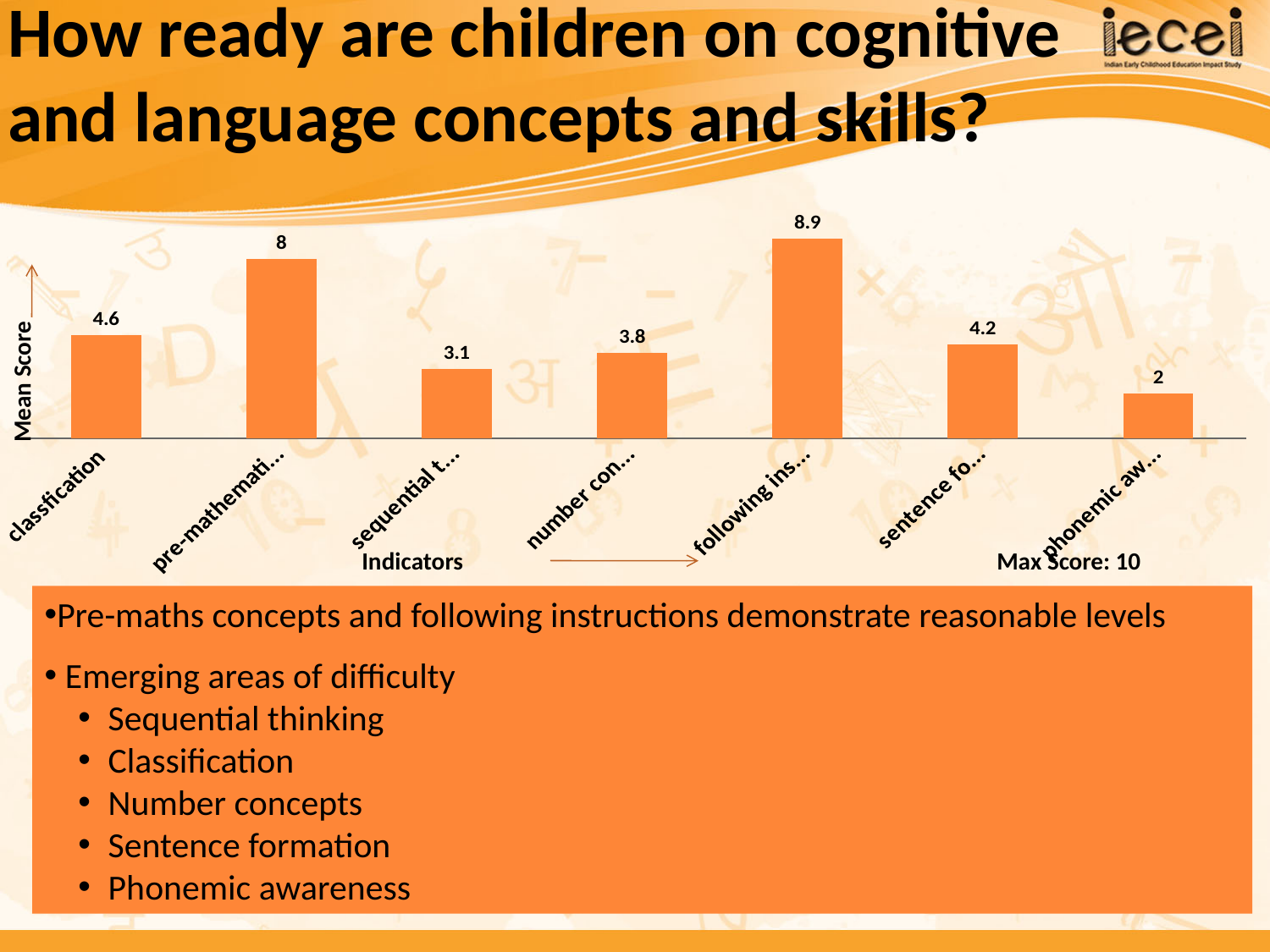
What is the mean score for classification? 4.6 What is the difference between the mean score for 'following ins...' and the mean score for 'pre-mathemati...'? 0.9 What is the mean score shown for the bar labelled 'phonemic aw...' (phonemic awareness)? 2 What type of chart is shown on the slide? bar chart What is the difference between the mean score for classification and the mean score for 'phonemic aw...'? 2.6 What is the mean score shown for the bar labelled 'sequential t...' (sequential thinking)? 3.1 Which indicator has the lowest mean score? phonemic aw... (phonemic awareness) What is the mean score shown for the bar labelled 'following ins...' (following instructions)? 8.9 Which indicator has the highest mean score? following ins... (following instructions) How many indicators (bars) are shown in the chart? 7 What is the maximum possible score noted on the chart? 10 Which has a higher mean score, classification or 'number con...' (number concepts)? classification